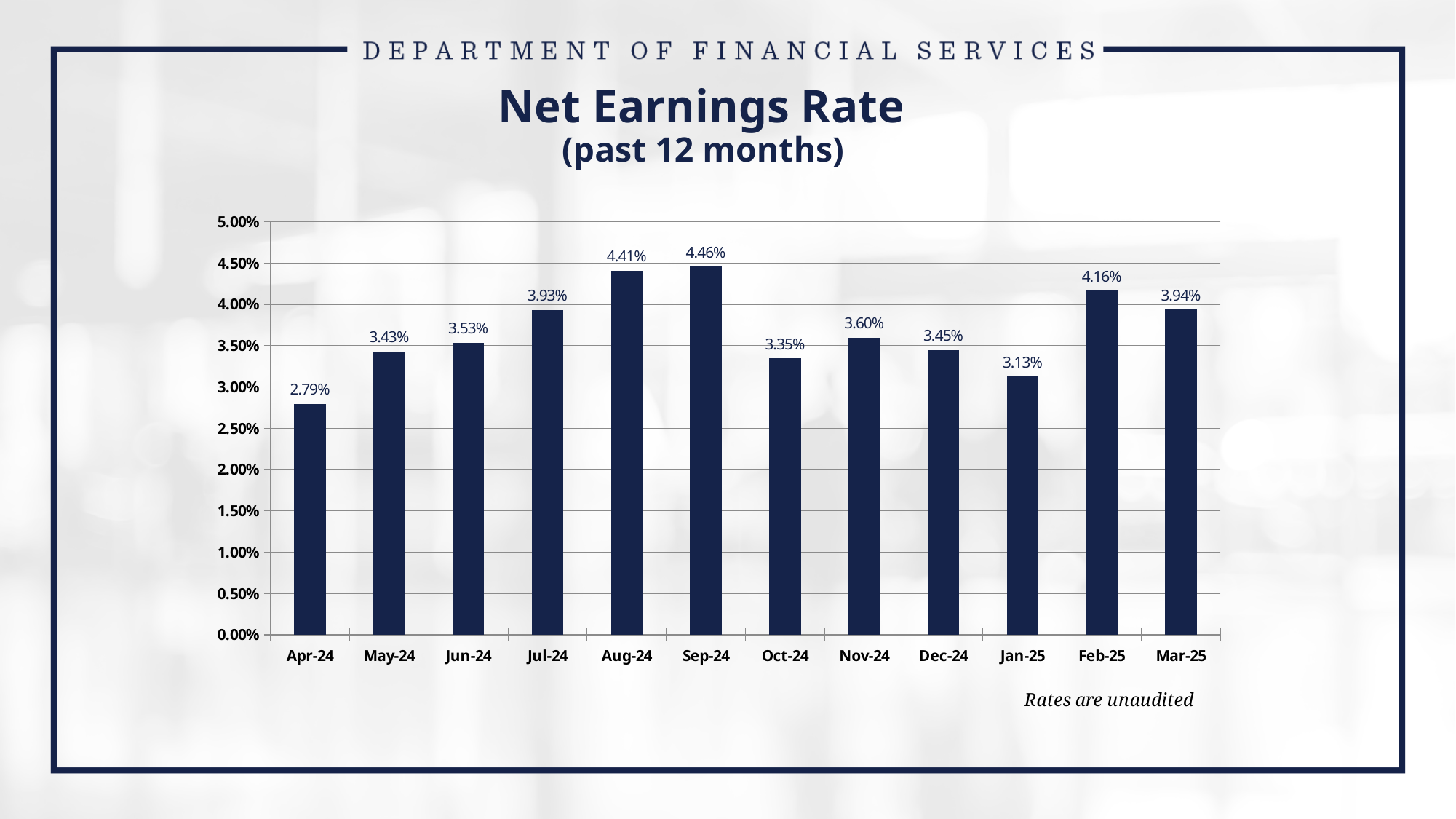
What note appears below the chart? Rates are unaudited What is the difference between the net earnings rate for Sep-24 and Apr-24? 1.67% What is the net earnings rate for Jan-25? 3.13% What is the net earnings rate for Apr-24? 2.79% What is the net earnings rate for Sep-24? 4.46% Which month has the highest net earnings rate? Sep-24 Which month has the lowest net earnings rate? Apr-24 Which month has a higher net earnings rate, Jul-24 or Nov-24? Jul-24 What is the difference between the net earnings rate for Feb-25 and Mar-25? 0.22% How many months are shown on the chart? 12 What kind of chart is shown on the slide? Bar chart Is the net earnings rate for Aug-24 greater or less than 4.00%? greater